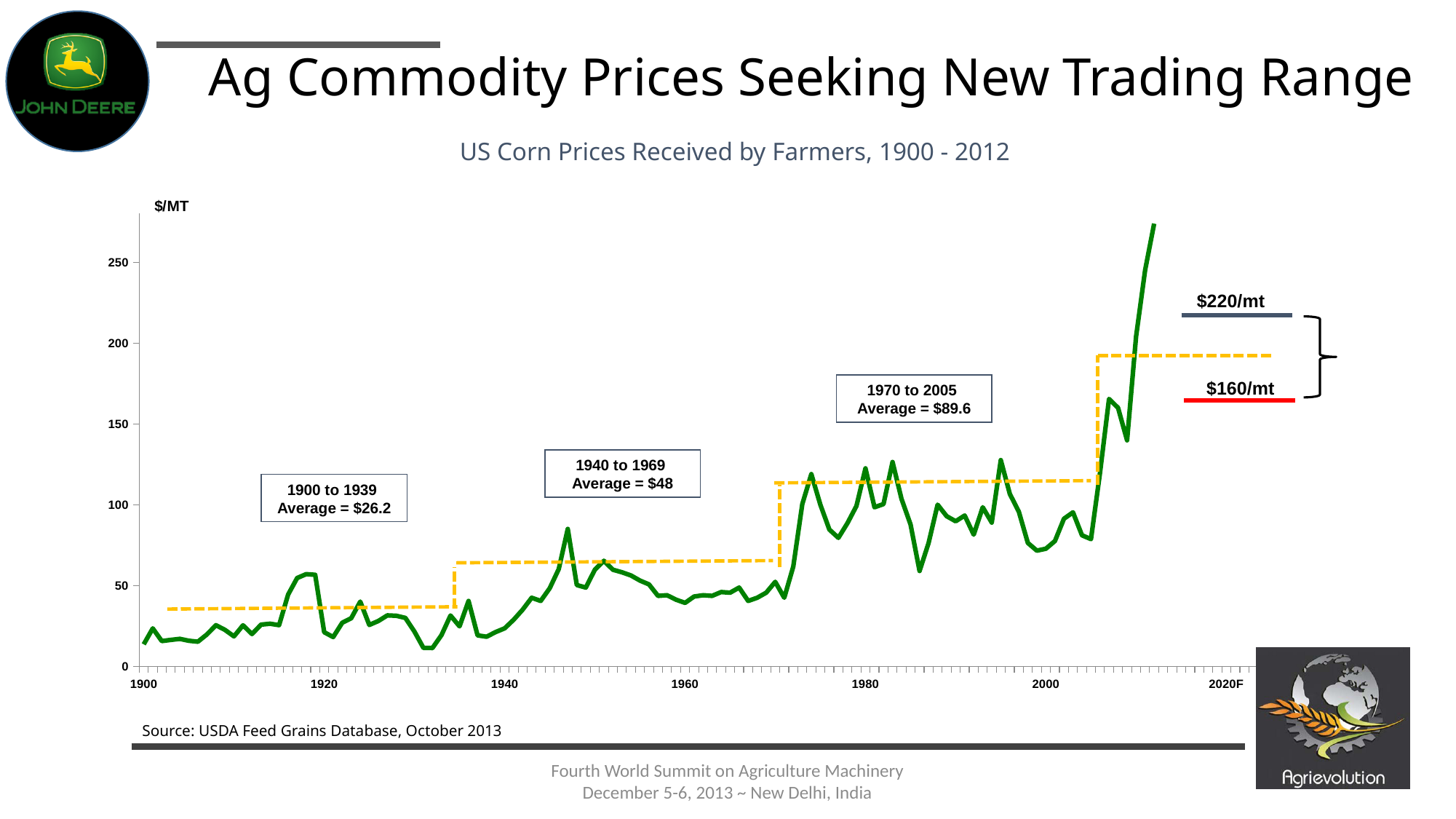
What kind of chart is shown on the slide? line chart What is the difference between the 1940 to 1969 average and the 1900 to 1939 average? $21.8 What unit is shown on the vertical axis of the chart? $/MT Which of the three labelled periods has the highest average price? 1970 to 2005 What is the average US corn price for the period 1970 to 2005? $89.6 What is the average US corn price for the period 1940 to 1969? $48 Which period has the higher average price, 1900 to 1939 or 1940 to 1969? 1940 to 1969 Overall, do US corn prices rise or fall from 1900 to 2012? rise Is the corn price in 1900 greater or less than 50 $/MT? less What is the difference between the 1970 to 2005 average and the 1940 to 1969 average? $41.6 What is the average US corn price for the period 1900 to 1939? $26.2 Is the peak corn price reached around 2012 greater or less than 250 $/MT? greater